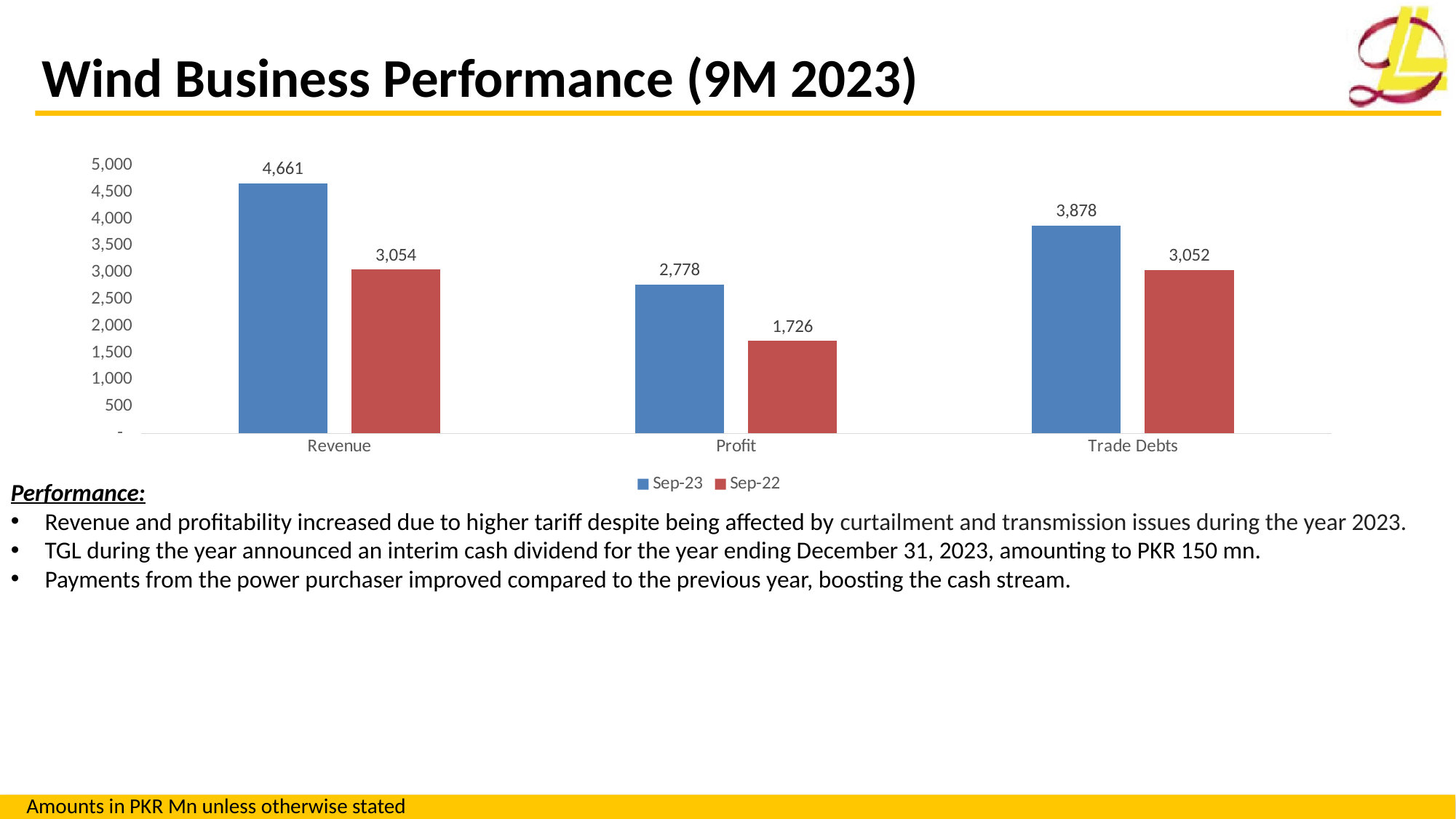
What is the Sep-23 value for Trade Debts? 3,878 Which category has the lowest Sep-22 value? Profit Which category has the highest Sep-23 value? Revenue How many categories are shown on the x axis? 3 How many series does the legend list? 2 Which is larger, the Sep-23 value for Trade Debts or the Sep-22 value for Trade Debts? Sep-23 What is the Sep-23 value for Revenue? 4,661 What is the difference between the Sep-23 and Sep-22 values for Revenue? 1,607 Is the Sep-22 value for Revenue greater or less than 3,500? less What kind of chart is shown on the slide? bar chart What is the difference between the Sep-23 and Sep-22 values for Profit? 1,052 What is the Sep-22 value for Profit? 1,726